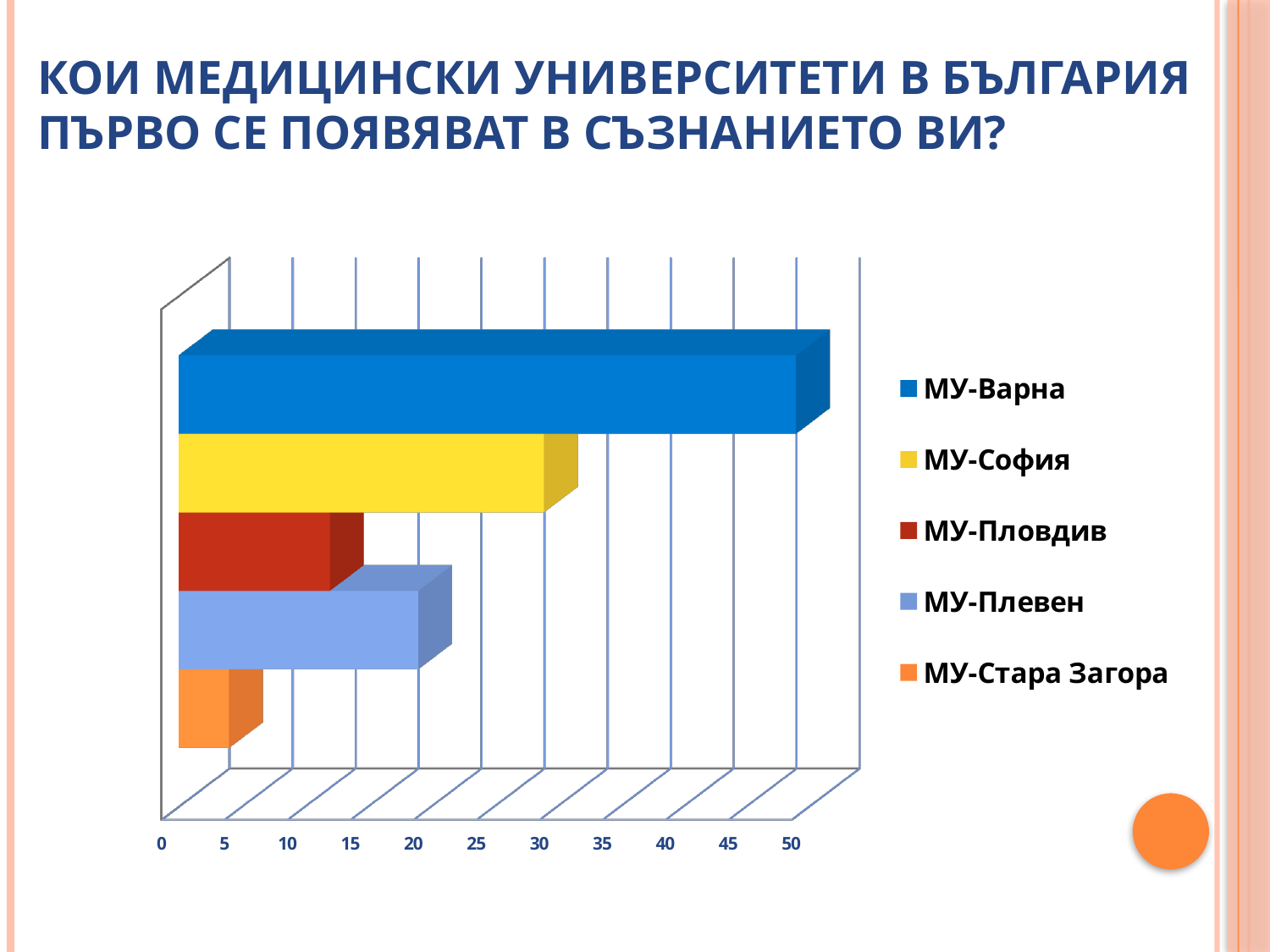
What kind of chart is shown on the slide? bar chart Which university has the lowest value in the chart? МУ-Стара Загора Is the value for МУ-София greater or less than 25? greater How many bars are plotted in the chart? 5 Which university has the highest value in the chart? МУ-Варна Is the value for МУ-Стара Загора greater or less than 10? less Is the value for МУ-Варна greater or less than 40? greater What colour is the bar for МУ-Стара Загора? orange Which has a larger value, МУ-София or МУ-Плевен? МУ-София How many series does the legend list? 5 Which has a larger value, МУ-Пловдив or МУ-Плевен? МУ-Плевен